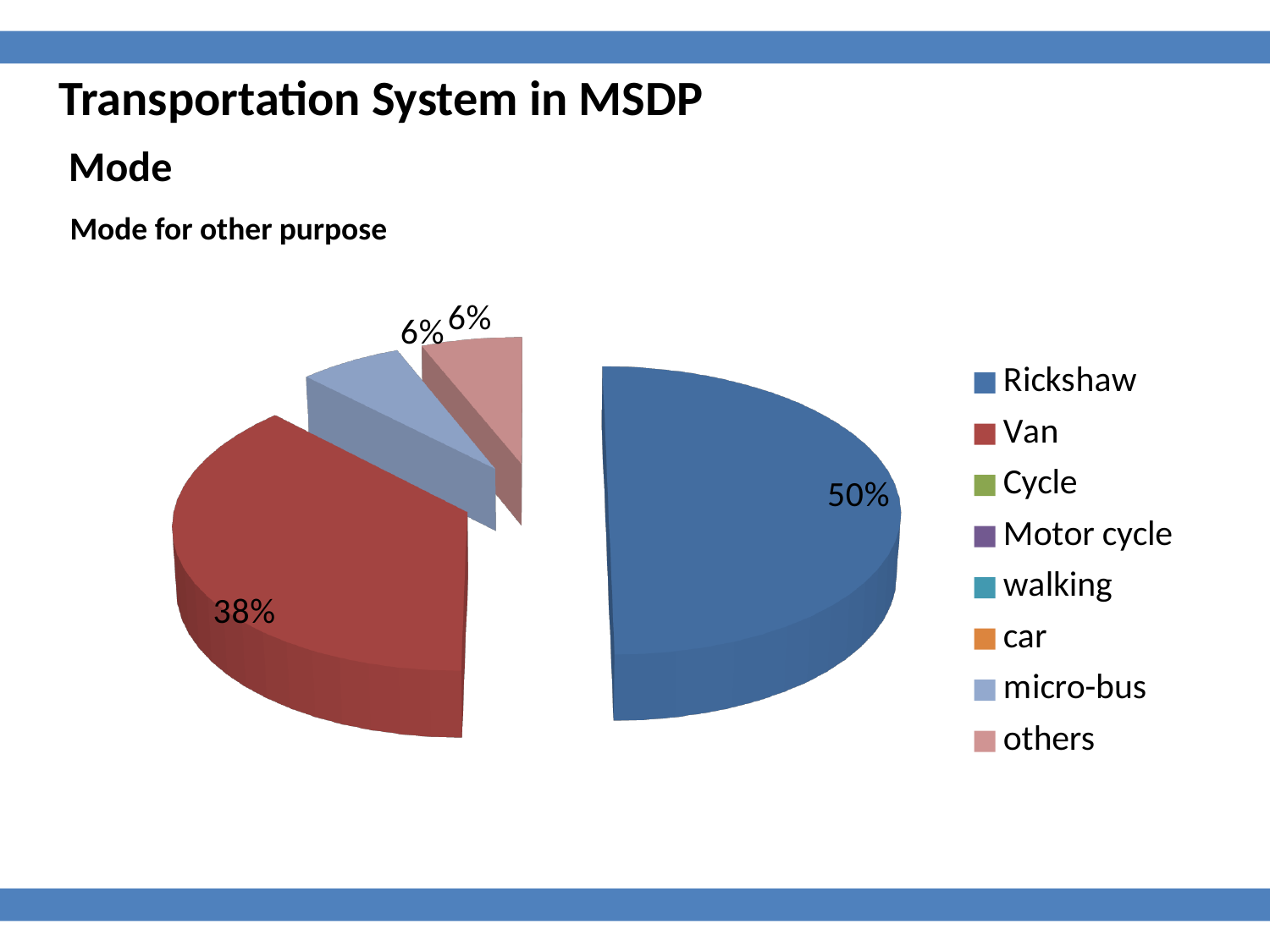
Which mode has the largest share of the pie? Rickshaw How many categories are listed in the legend? 8 What percentage is shown for others? 6% What is the combined share of Rickshaw and Van? 88% By how many percentage points does Rickshaw exceed Van? 12 percentage points What percentage is shown for micro-bus? 6% What kind of chart is shown on the slide? Pie chart What is the subtitle above the chart? Mode for other purpose Which has a larger share, Rickshaw or Van? Rickshaw What colour is the Rickshaw slice? Blue What share of the pie does Rickshaw account for? 50% What percentage is shown for Van? 38%